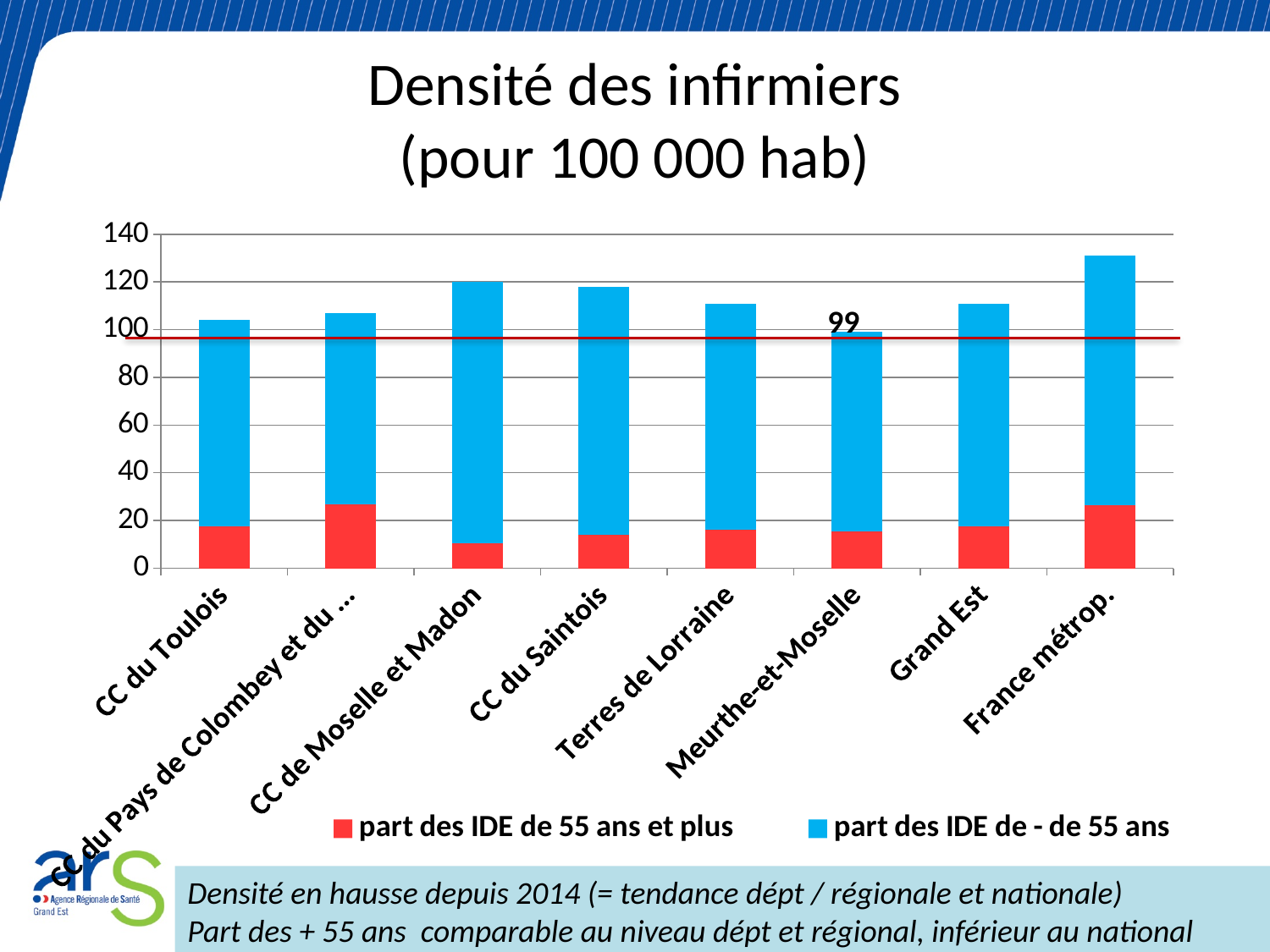
Which category has the lowest total bar? Meurthe-et-Moselle What is the labelled total value for Meurthe-et-Moselle? 99 Is the total bar for France métrop. greater or less than 120? greater How many series does the legend list? 2 Which has the taller total bar, CC de Moselle et Madon or Terres de Lorraine? CC de Moselle et Madon What kind of chart is shown on the slide? Stacked bar chart Is the total bar for CC de Moselle et Madon greater or less than 100? greater Which category has the highest total bar? France métrop. Which has the taller total bar, France métrop. or Grand Est? France métrop. How many categories are shown on the x axis? 8 Which category has the smallest red segment (part des IDE de 55 ans et plus)? CC de Moselle et Madon Is the total bar for CC du Toulois greater or less than 120? less